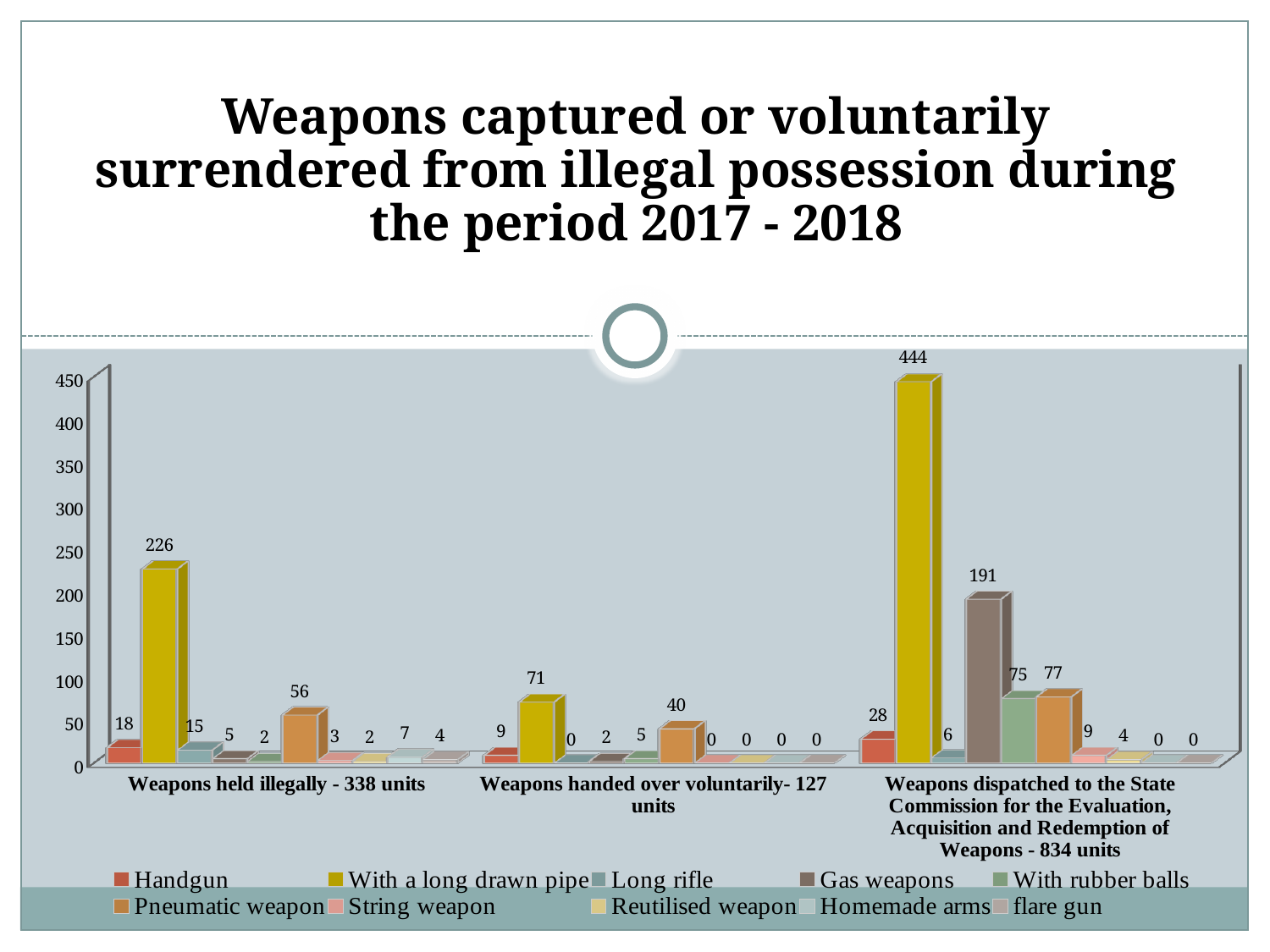
How many series does the legend list? 10 How many categories are shown on the x axis? 3 What is the value for 'Pneumatic weapon' in the 'Weapons handed over voluntarily- 127 units' category? 40 What is the difference between the 'With a long drawn pipe' values for 'Weapons dispatched to the State Commission for the Evaluation, Acquisition and Redemption of Weapons - 834 units' and 'Weapons held illegally - 338 units'? 218 Is the value for 'With a long drawn pipe' in the 'Weapons dispatched to the State Commission for the Evaluation, Acquisition and Redemption of Weapons - 834 units' category greater or less than 400? greater What type of chart is shown on the slide? bar chart What is the value for 'With a long drawn pipe' in the 'Weapons held illegally - 338 units' category? 226 What is the value for 'Gas weapons' in the 'Weapons dispatched to the State Commission for the Evaluation, Acquisition and Redemption of Weapons - 834 units' category? 191 What is the title of the chart on the slide? Weapons captured or voluntarily surrendered from illegal possession during the period 2017 - 2018 Which series has the highest value in the 'Weapons dispatched to the State Commission for the Evaluation, Acquisition and Redemption of Weapons - 834 units' category? With a long drawn pipe Which is larger in the 'Weapons dispatched to the State Commission for the Evaluation, Acquisition and Redemption of Weapons - 834 units' category: 'With rubber balls' or 'Pneumatic weapon'? Pneumatic weapon What is the value for 'Handgun' in the 'Weapons handed over voluntarily- 127 units' category? 9